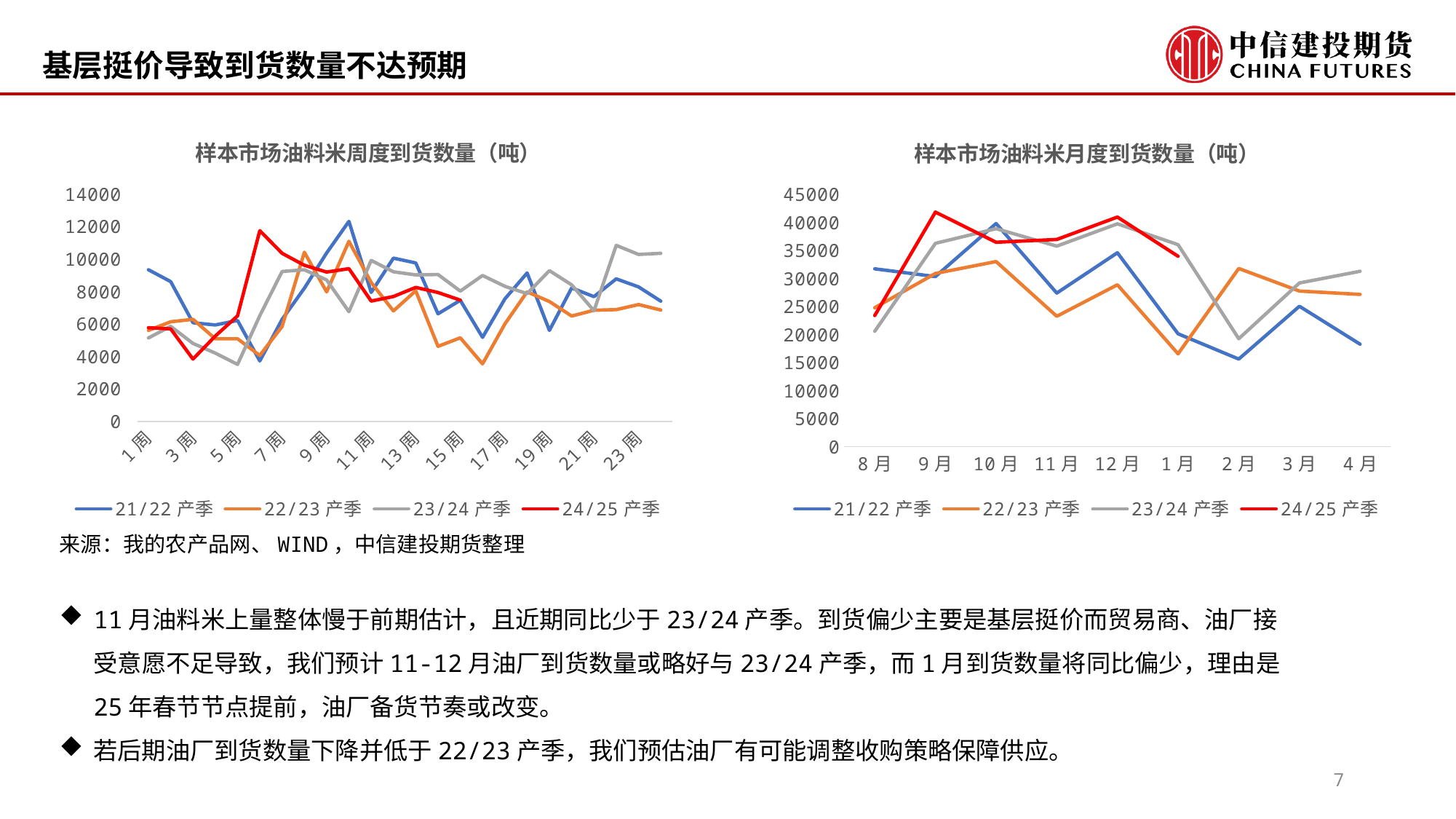
What kind of chart is the left chart titled 样本市场油料米周度到货数量（吨）? line chart In the right chart (样本市场油料米月度到货数量), is the value for 21/22 产季 in 2月 greater or less than 20000? less In the left chart (样本市场油料米周度到货数量), which is larger at 23周: 23/24 产季 or 22/23 产季? 23/24 产季 In the right chart (样本市场油料米月度到货数量), which is larger in 4月: 23/24 产季 or 21/22 产季? 23/24 产季 In the right chart (样本市场油料米月度到货数量), does the 21/22 产季 line rise or fall from 12月 to 2月? fall In the right chart (样本市场油料米月度到货数量), which series has the lowest value in 1月? 22/23 产季 What is the title of the right chart? 样本市场油料米月度到货数量（吨） In the right chart (样本市场油料米月度到货数量), is the value for 24/25 产季 in 9月 greater or less than 40000? greater In the right chart (样本市场油料米月度到货数量), which series has the highest value in 9月? 24/25 产季 How many series does the legend of the right chart (样本市场油料米月度到货数量) list? 4 In the right chart (样本市场油料米月度到货数量), how many months are shown on the x axis? 9